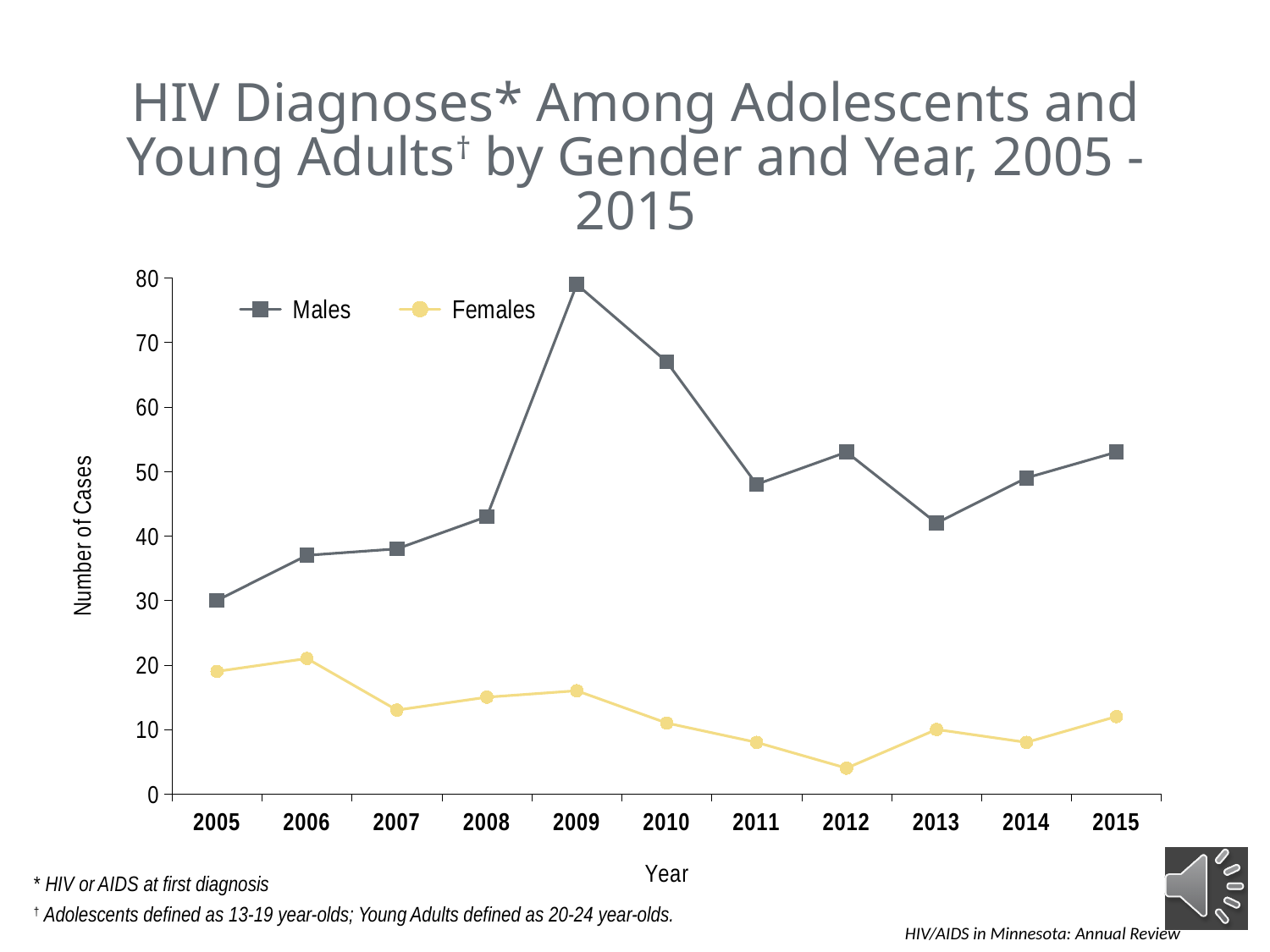
What is the label of the y axis? Number of Cases In which year is the number of cases for Males lowest? 2005 Which series has the larger value in 2009, Males or Females? Males Is the value for Males in 2009 greater or less than 70? greater How many series does the legend list? 2 Is the value for Females in 2012 greater or less than 10? less Is the value for Males in 2010 greater or less than 60? greater How many years are plotted along the x axis? 11 In which year is the number of cases for Females lowest? 2012 Do the values for Males rise or fall from 2005 to 2009? Rise In which year is the number of cases for Males highest? 2009 What kind of chart is shown on the slide? Line chart